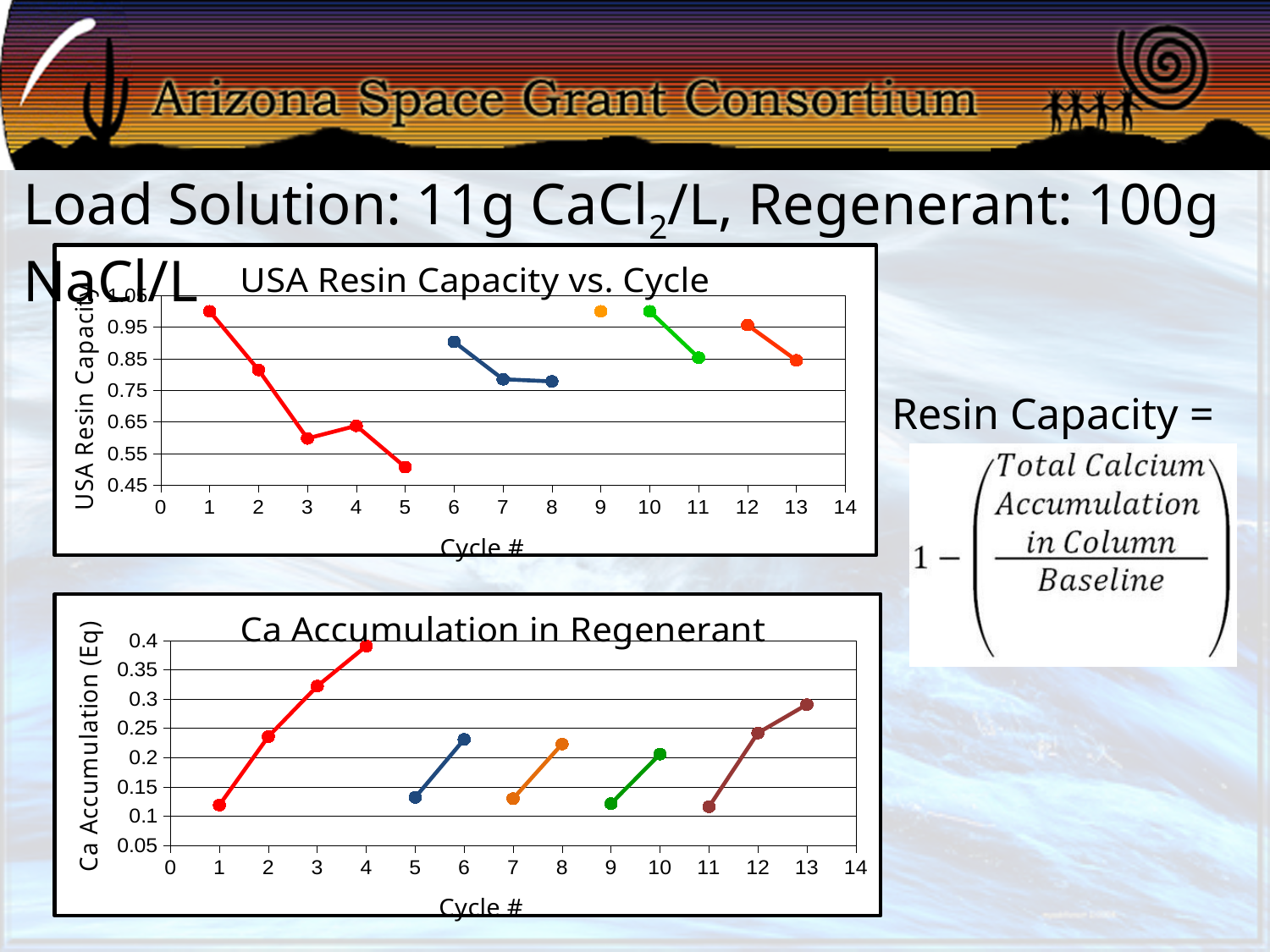
In the 'USA Resin Capacity vs. Cycle' chart, which cycle has the lowest resin capacity? 5 In the 'USA Resin Capacity vs. Cycle' chart, is the value at cycle 1 greater or less than 0.95? greater In the 'USA Resin Capacity vs. Cycle' chart, is the value at cycle 3 greater or less than 0.65? less In the 'Ca Accumulation in Regenerant' chart, do the values rise or fall from cycle 1 to cycle 4? rise In the 'USA Resin Capacity vs. Cycle' chart, do the values rise or fall from cycle 1 to cycle 5? fall In the 'Ca Accumulation in Regenerant' chart, is the value at cycle 4 greater or less than 0.35? greater In the 'Ca Accumulation in Regenerant' chart, which cycle has the highest Ca accumulation? 4 What type of chart is the 'Ca Accumulation in Regenerant' chart? line chart What is the x-axis title of the 'Ca Accumulation in Regenerant' chart? Cycle # What type of chart is the 'USA Resin Capacity vs. Cycle' chart? line chart